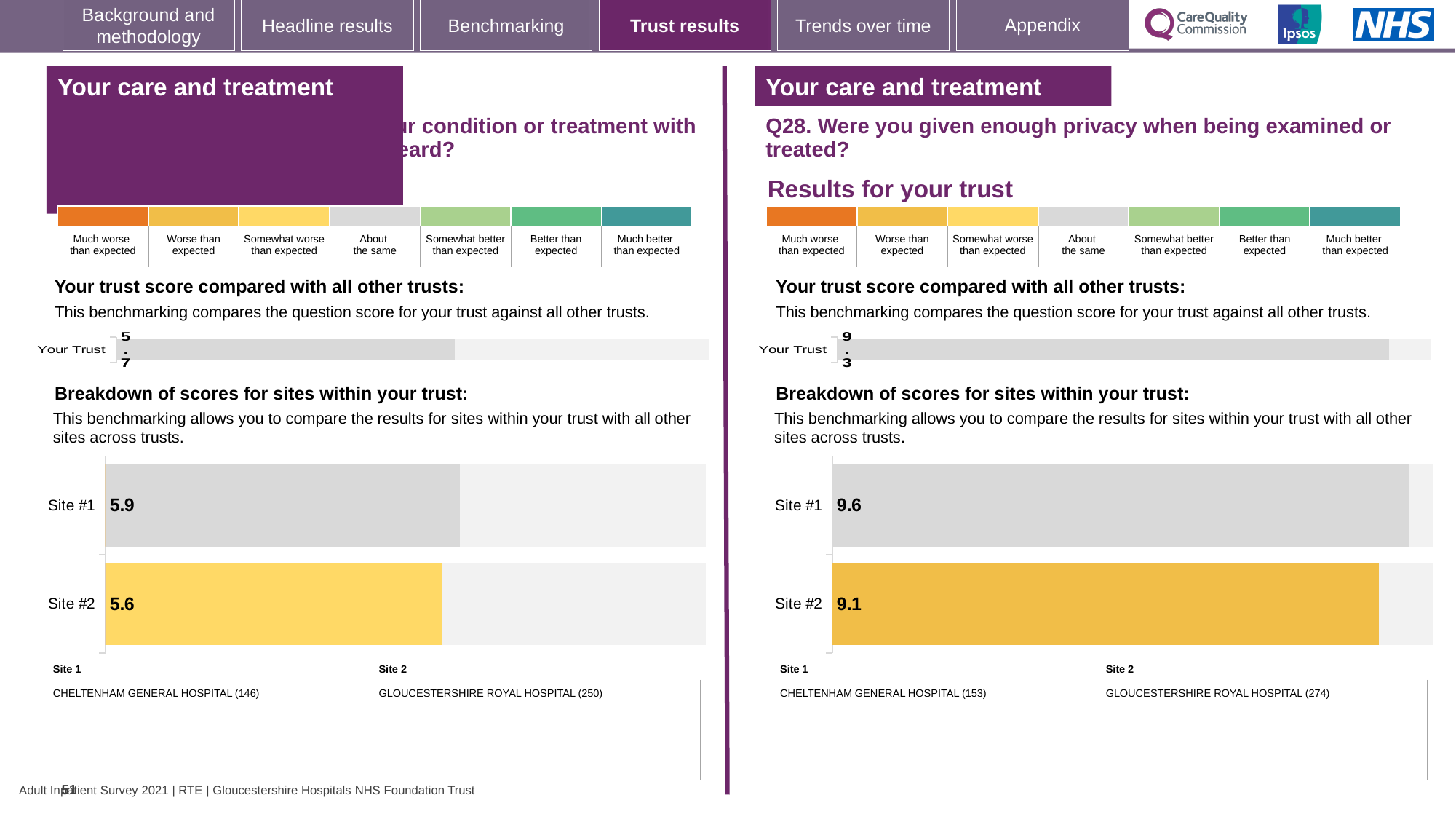
On the right-hand panel (Q28), what is the 'Your Trust' score shown in the trust benchmarking bar? 9.3 How many sites are shown in the site breakdown chart on the right-hand panel (Q28)? 2 On the right-hand chart (Q28), what is the difference between the Site #1 and Site #2 scores? 0.5 On the left-hand panel, what is the 'Your Trust' score shown in the trust benchmarking bar? 5.7 On the right-hand chart (Q28, privacy when being examined or treated), what is the score for Site #1? 9.6 On the right-hand chart (Q28), what is the score for Site #2? 9.1 On the left-hand site breakdown chart, what is the score for Site #1? 5.9 What type of chart is used for the site breakdown on the right-hand panel (Q28)? Bar chart On the left-hand site breakdown chart, which site has the lower score? Site #2 On the right-hand chart (Q28), which site has the higher score? Site #1 On the left-hand site breakdown chart, what is the difference between the Site #1 and Site #2 scores? 0.3 On the left-hand site breakdown chart, what is the score for Site #2? 5.6